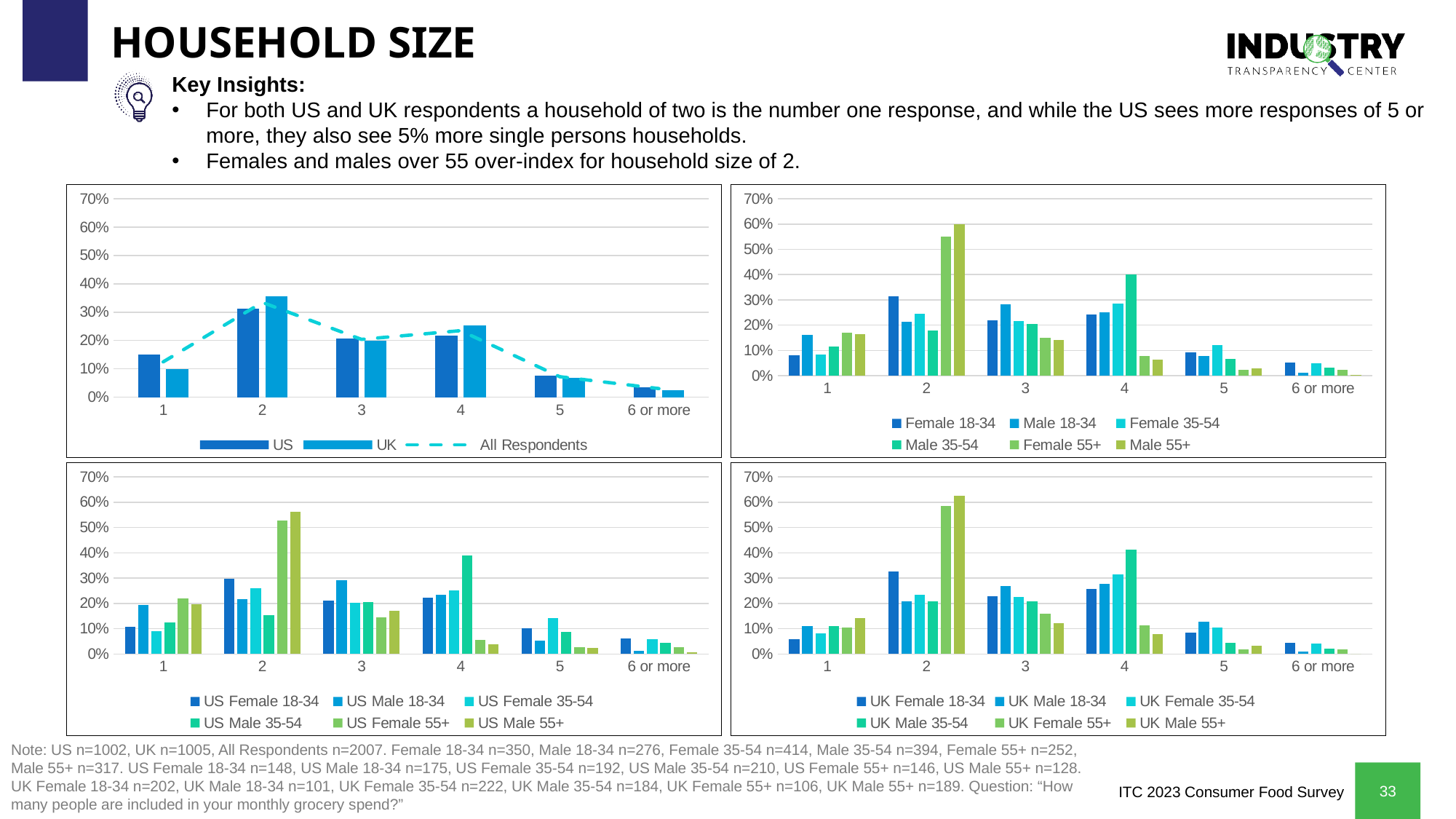
In the top-right chart, is the Male 55+ value for household size 2 greater or less than 50%? greater In the top-left chart, which household size has the lowest US value? 6 or more In the top-left chart, how many household size categories are shown on the x axis? 6 In the top-left chart, which household size has the highest UK value? 2 In the top-left chart, how many series does the legend list? 3 In the top-right chart, which series has the highest value for household size 2? Male 55+ In the top-left chart, is the US value for household size 1 greater or less than 10%? greater In the top-left chart, which is larger for household size 1, US or UK? US In the top-left chart, do the US values rise or fall from household size 4 to 6 or more? fall In the bottom-right chart, how many series does the legend list? 6 In the top-left chart, is the UK value for household size 2 greater or less than 30%? greater In the bottom-left chart, which series has the highest value for household size 4? US Male 35-54